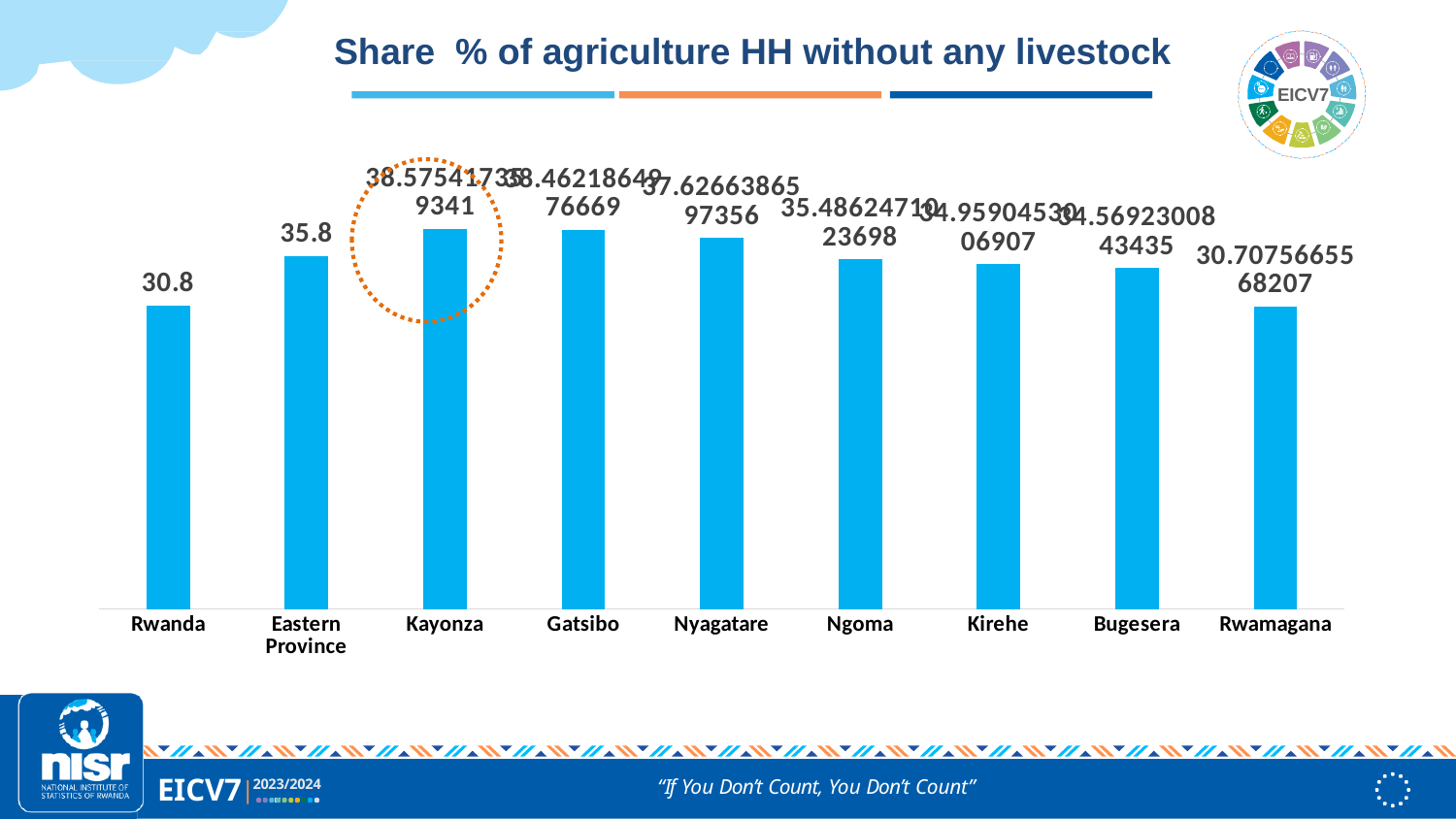
Which is larger, the value for Kirehe or the value for Rwamagana? Kirehe Which is larger, the value for Eastern Province or the value for Rwanda? Eastern Province What is the value for Eastern Province? 35.8 How many categories are shown on the x axis? 9 What is the difference between the values for Eastern Province and Rwanda? 5 What is the title of the chart? Share % of agriculture HH without any livestock Which is larger, the value for Nyagatare or the value for Ngoma? Nyagatare What kind of chart is shown on the slide? Bar chart What is the value for Rwanda? 30.8 Which category's bar is highlighted with a dotted orange circle? Kayonza